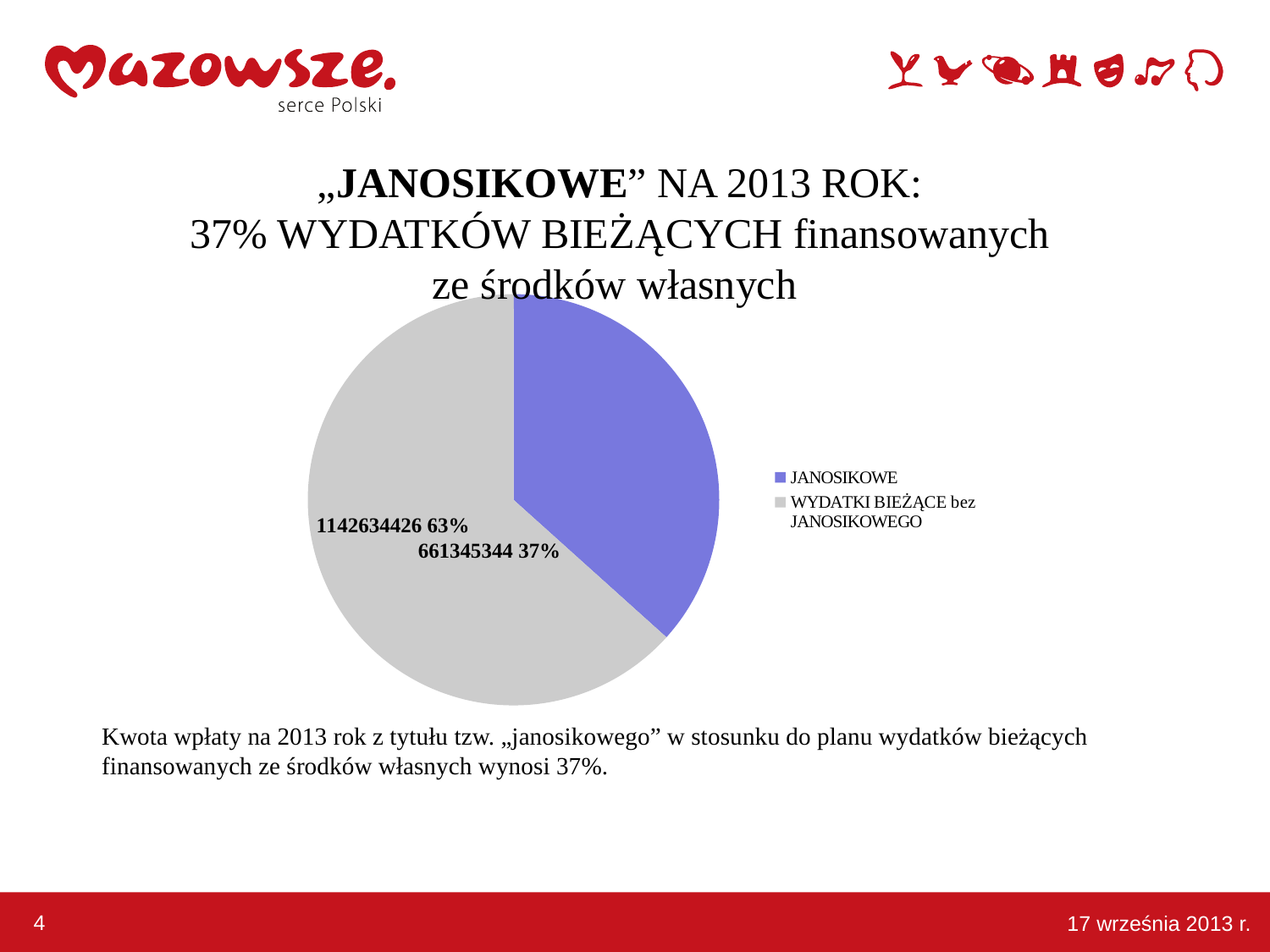
What share of the pie does the JANOSIKOWE slice represent? 37% What share of the pie does the WYDATKI BIEŻĄCE bez JANOSIKOWEGO slice represent? 63% What colour is the JANOSIKOWE slice in the pie chart? blue How many entries does the legend of the pie chart list? 2 What is the difference between the values of the WYDATKI BIEŻĄCE bez JANOSIKOWEGO slice and the JANOSIKOWE slice? 481289082 How many slices does the pie chart have? 2 What kind of chart is shown on the slide? pie chart Which slice of the pie chart is the largest? WYDATKI BIEŻĄCE bez JANOSIKOWEGO What is the value shown for the WYDATKI BIEŻĄCE bez JANOSIKOWEGO slice? 1142634426 What is the value shown for the JANOSIKOWE slice? 661345344 Which is larger, the JANOSIKOWE slice or the WYDATKI BIEŻĄCE bez JANOSIKOWEGO slice? WYDATKI BIEŻĄCE bez JANOSIKOWEGO Which slice of the pie chart is the smallest? JANOSIKOWE